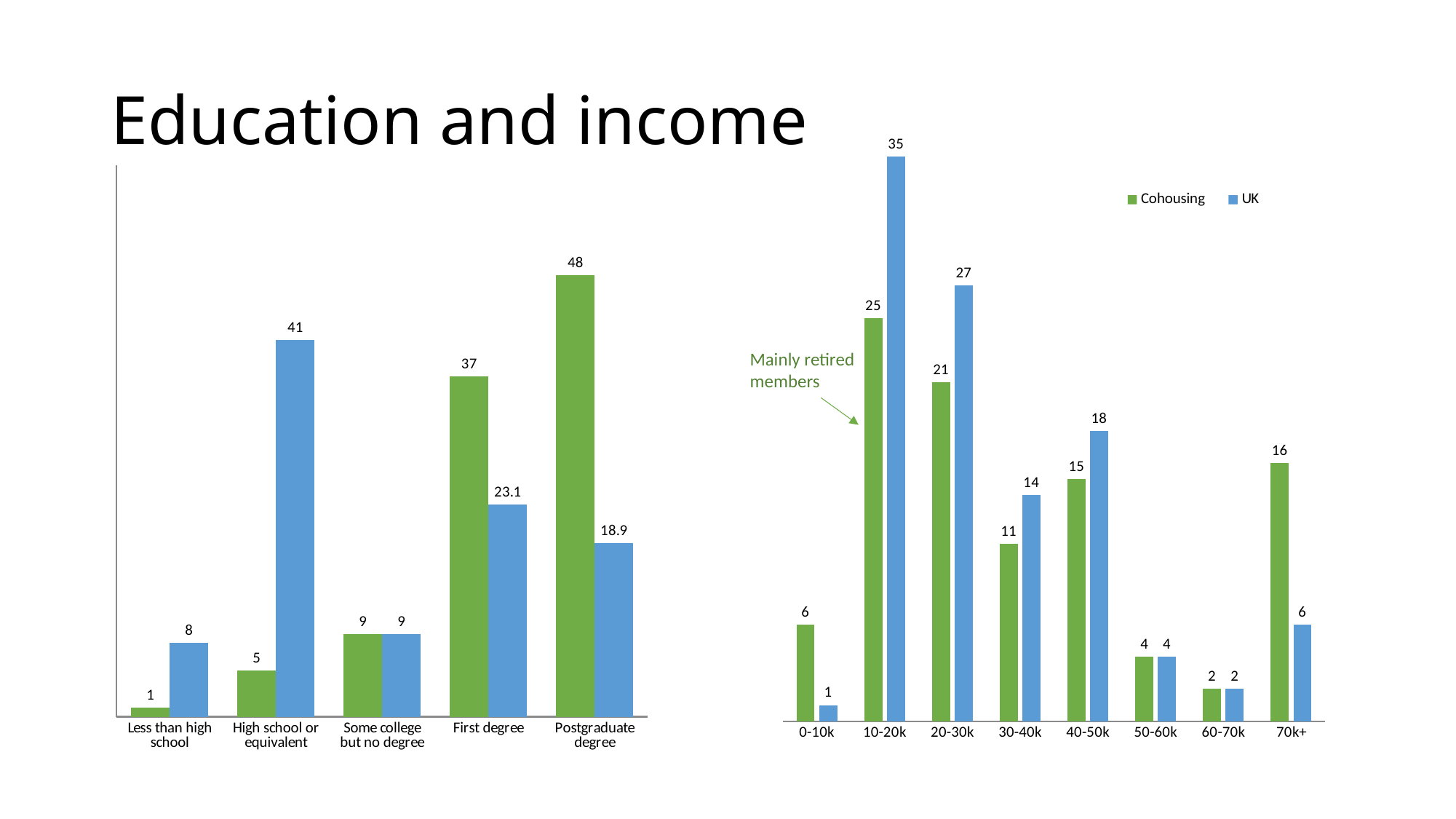
In the right-hand income chart, what is the difference between the UK and Cohousing values for the 20-30k band? 6 What type of chart is the left-hand education chart? Bar chart In the left-hand education chart, what is the value of the blue bar for High school or equivalent? 41 In the left-hand education chart, which category has the lowest green bar? Less than high school In the right-hand income chart, which is larger for the 40-50k band, Cohousing or UK? UK In the left-hand education chart, what is the difference between the green and blue bars for First degree? 13.9 In the right-hand income chart, what is the UK value for the 70k+ band? 6 In the right-hand income chart, what is the Cohousing value for the 10-20k band? 25 How many series does the legend of the right-hand income chart list? 2 In the right-hand income chart, which income band has the highest UK value? 10-20k In the left-hand education chart, what is the value of the green bar for Postgraduate degree? 48 How many income bands are shown on the x axis of the right-hand chart? 8